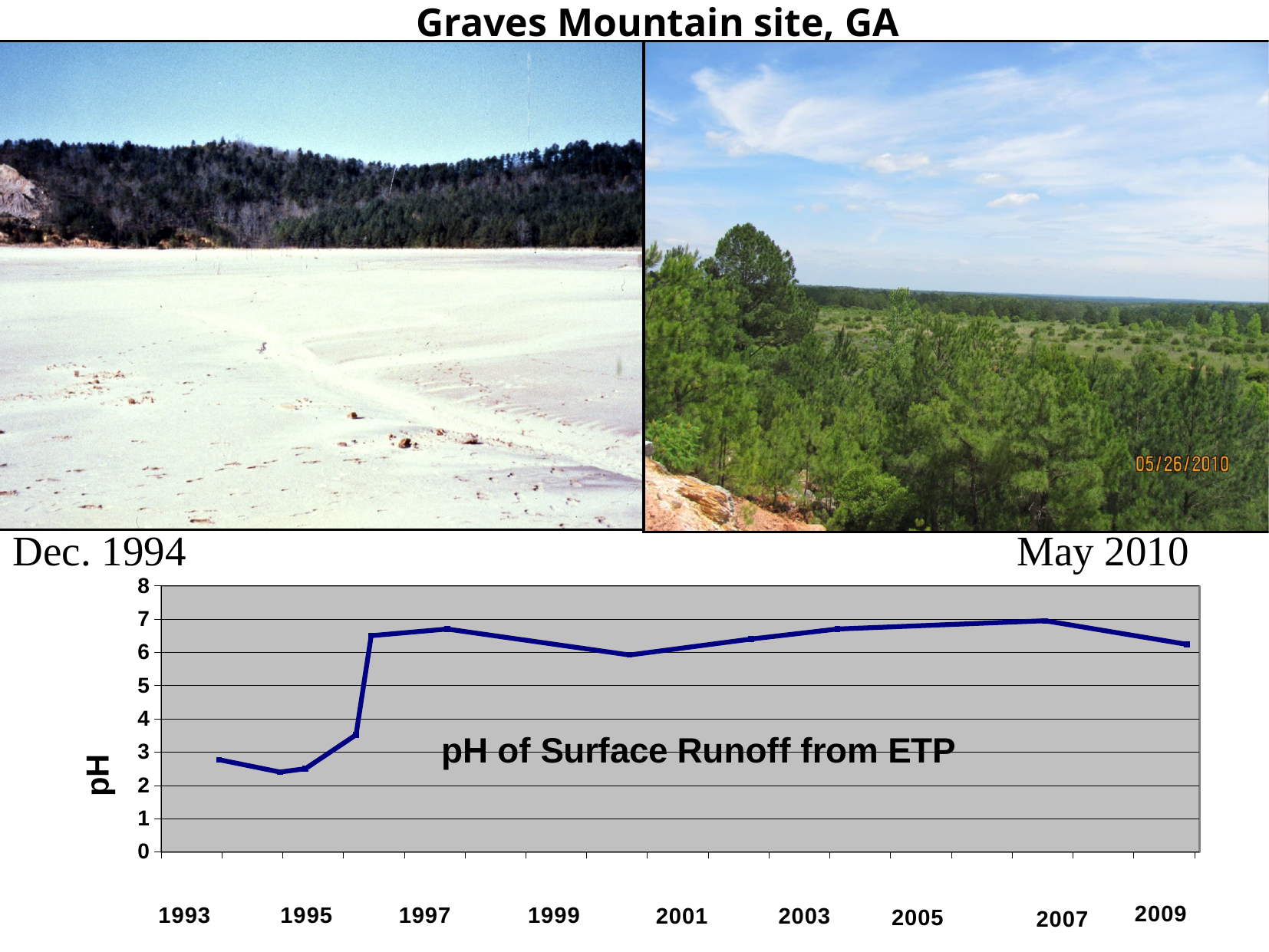
Around which year is the pH lowest in the chart? 1995 Which is larger, the pH around 1995 or the pH around 2005? 2005 What kind of chart is shown at the bottom of the slide? line chart Is the pH value around 2009 greater or less than 7? less Is the pH value around 2001 greater or less than 5? greater Is the pH value around 1995 greater or less than 4? less How many year labels are shown along the x axis of the chart? 9 Which is larger, the pH at the start of the series (1993) or at the end (2009)? 2009 What is the title of the chart at the bottom of the slide? pH of Surface Runoff from ETP Overall, does the pH rise or fall from 1993 to 2009 in the chart? rise What is the label on the vertical axis of the chart? pH